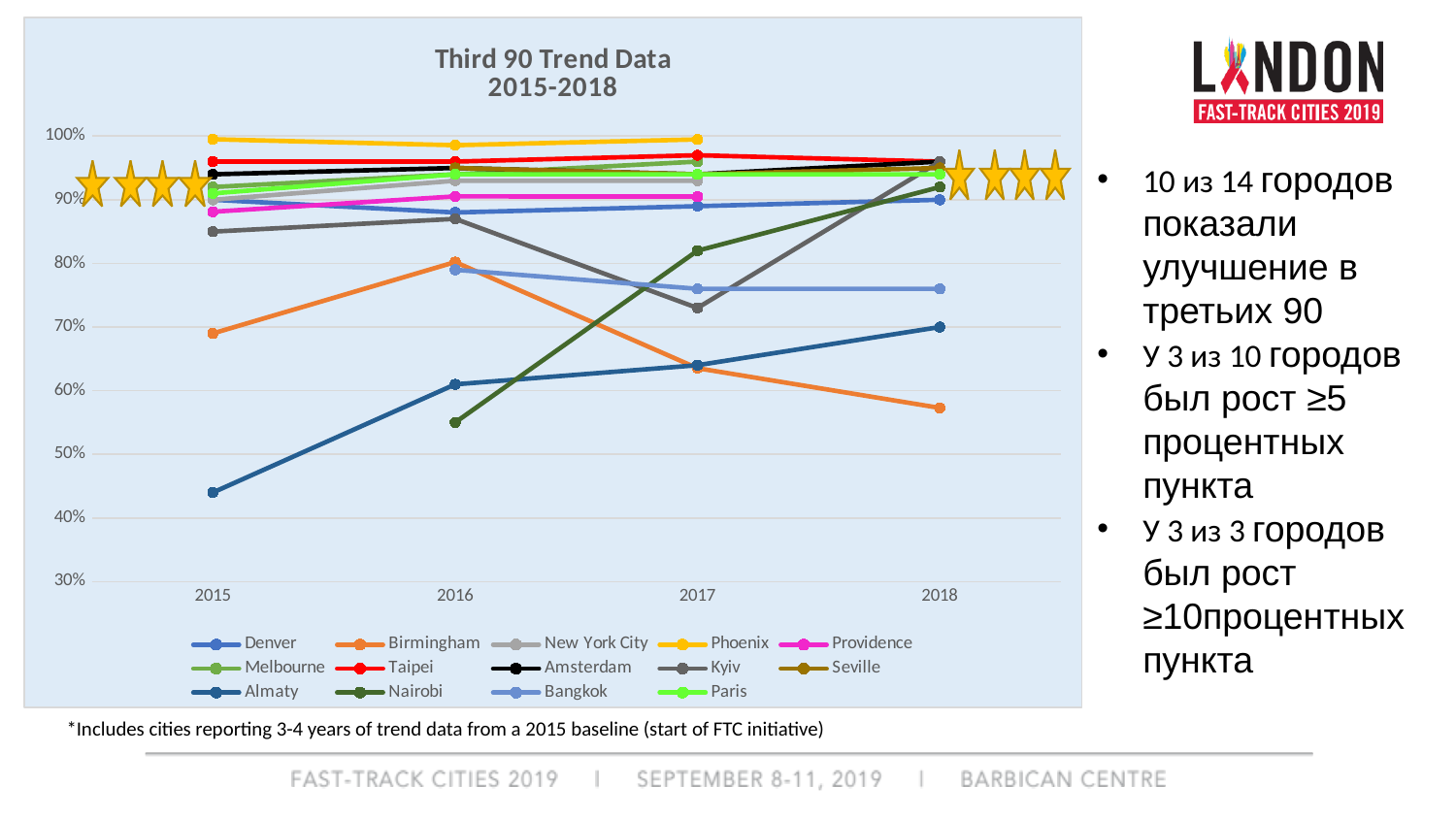
How many years are shown along the x axis of the chart? 4 How many series does the chart legend list? 14 Is the value for Bangkok in 2018 greater or less than 80%? less What is the title of the chart? Third 90 Trend Data 2015-2018 Which city has the highest value in 2015? Phoenix What kind of chart is shown on the slide? line chart Is the value for Birmingham in 2018 greater or less than 60%? less Does the value for Almaty rise or fall from 2015 to 2018? rise Is the value for Almaty in 2015 greater or less than 50%? less Which city has the lowest value in 2018? Birmingham Which city has the lowest value in 2015? Almaty In 2017, which is larger: the value for Nairobi or the value for Bangkok? Nairobi